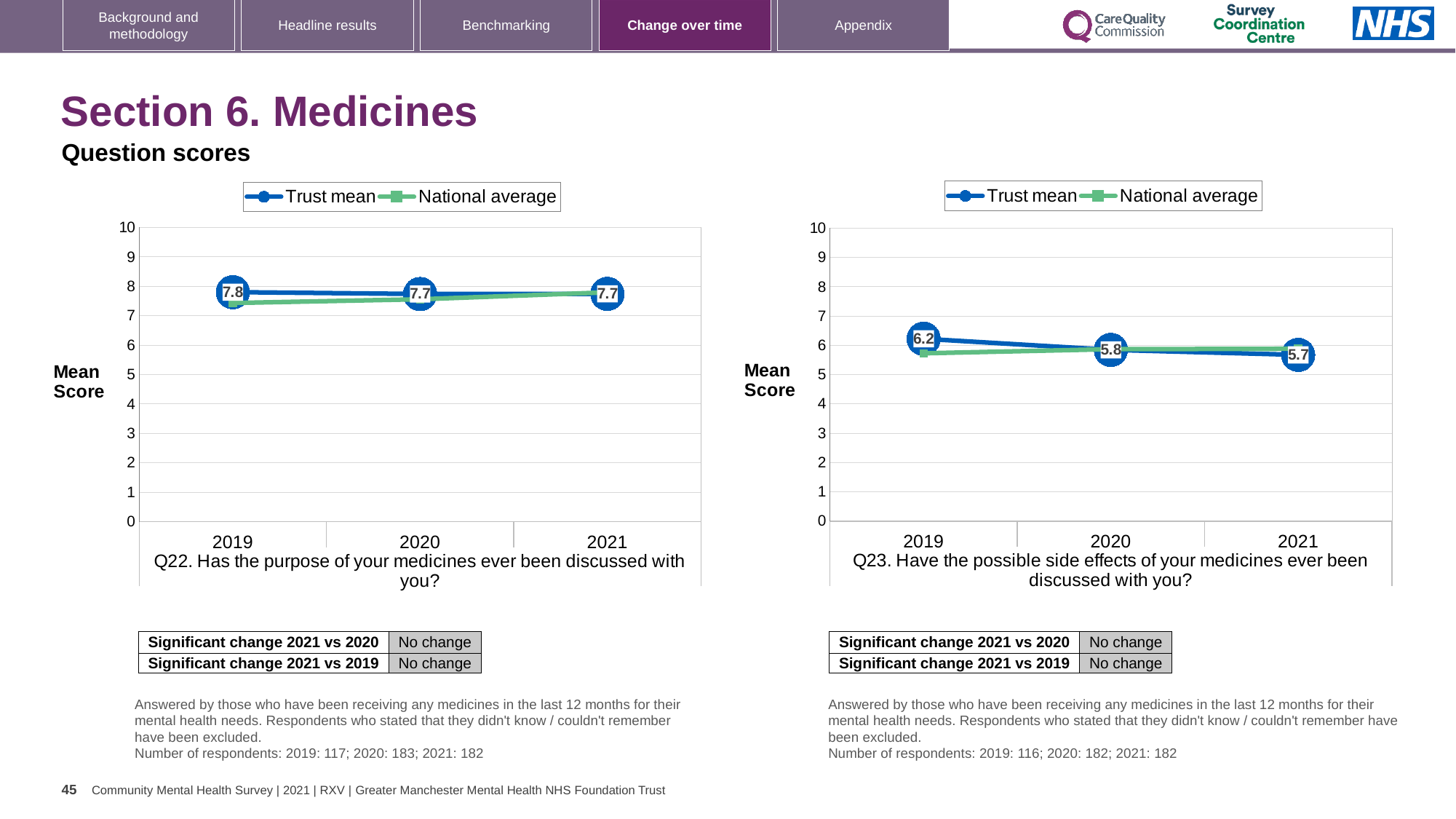
In the Q23 chart on the right, which year has the highest Trust mean score? 2019 In the Q22 chart on the left, what is the Trust mean score for 2019? 7.8 In the Q23 chart on the right, in 2019 is the Trust mean or the National average higher? Trust mean In the Q22 chart on the left, what is the difference between the Trust mean scores for 2019 and 2020? 0.1 In the Q22 chart on the left, what is the Trust mean score for 2021? 7.7 In the Q23 chart on the right, what is the difference between the Trust mean scores for 2019 and 2021? 0.5 In the Q23 chart on the right, does the Trust mean rise or fall from 2019 to 2021? fall In the Q23 chart on the right, what is the Trust mean score for 2021? 5.7 What type of chart is the Q23 chart on the right? line chart In the Q23 chart on the right, what is the Trust mean score for 2019? 6.2 How many series does the legend of the Q22 chart on the left list? 2 In the Q23 chart on the right, which year has the lowest Trust mean score? 2021